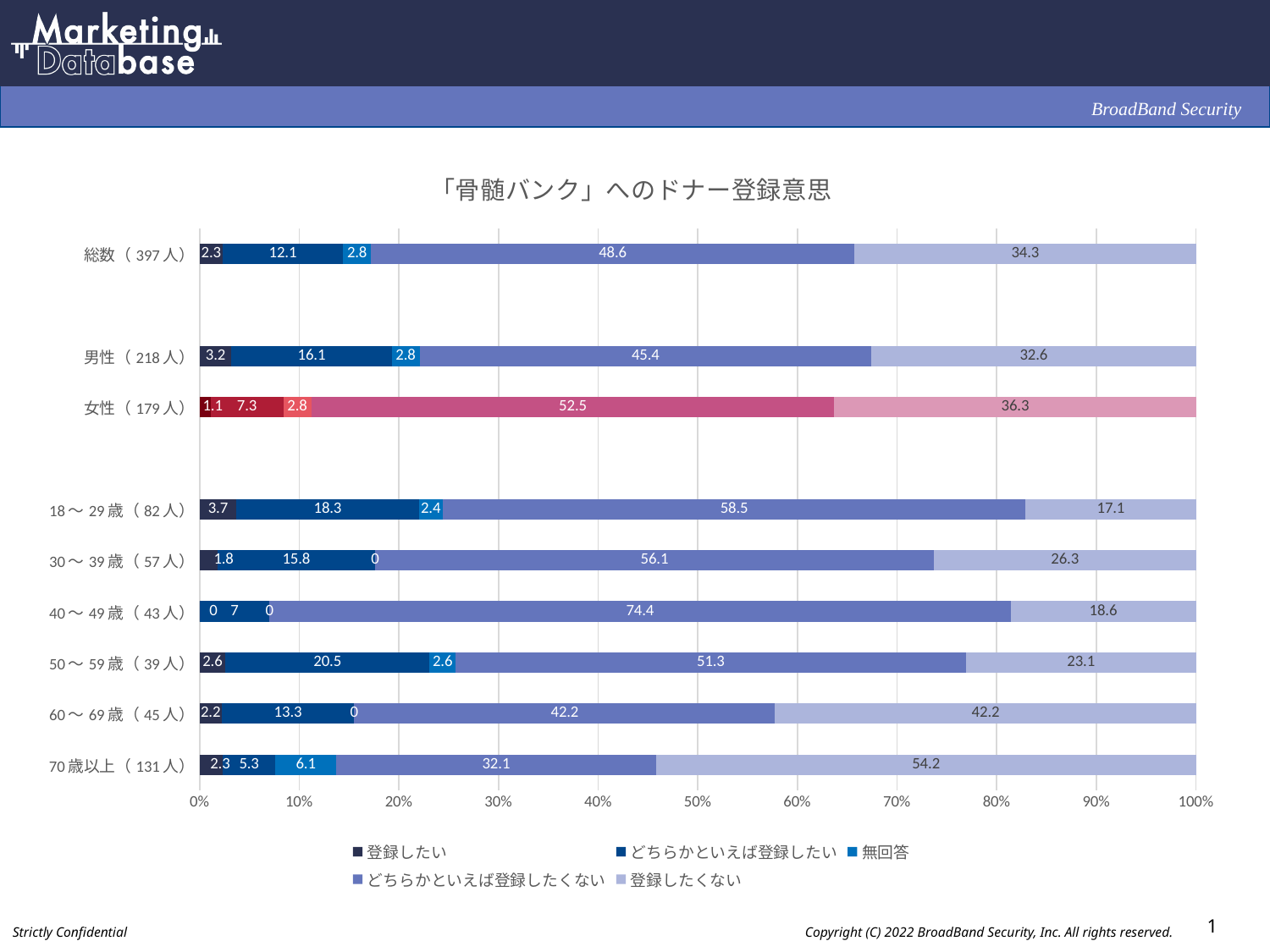
What type of chart is shown on the slide? stacked bar chart What is the value of どちらかといえば登録したい for 50〜59歳 (39人)? 20.5 What is the value of 無回答 for 70歳以上 (131人)? 6.1 Which category has the lowest value for 登録したくない? 18〜29歳 (82人) What is the value of 登録したくない for 70歳以上 (131人)? 54.2 What is the title of the chart? 「骨髄バンク」へのドナー登録意思 What is the difference between the 登録したくない values for 女性 (179人) and 男性 (218人)? 3.7 How many category bars are plotted in the chart? 9 How many series does the legend list? 5 What is the value of どちらかといえば登録したくない for 総数 (397人)? 48.6 Which is larger, the どちらかといえば登録したい value for 男性 (218人) or for 女性 (179人)? 男性 (218人) Which category has the highest value for どちらかといえば登録したくない? 40〜49歳 (43人)